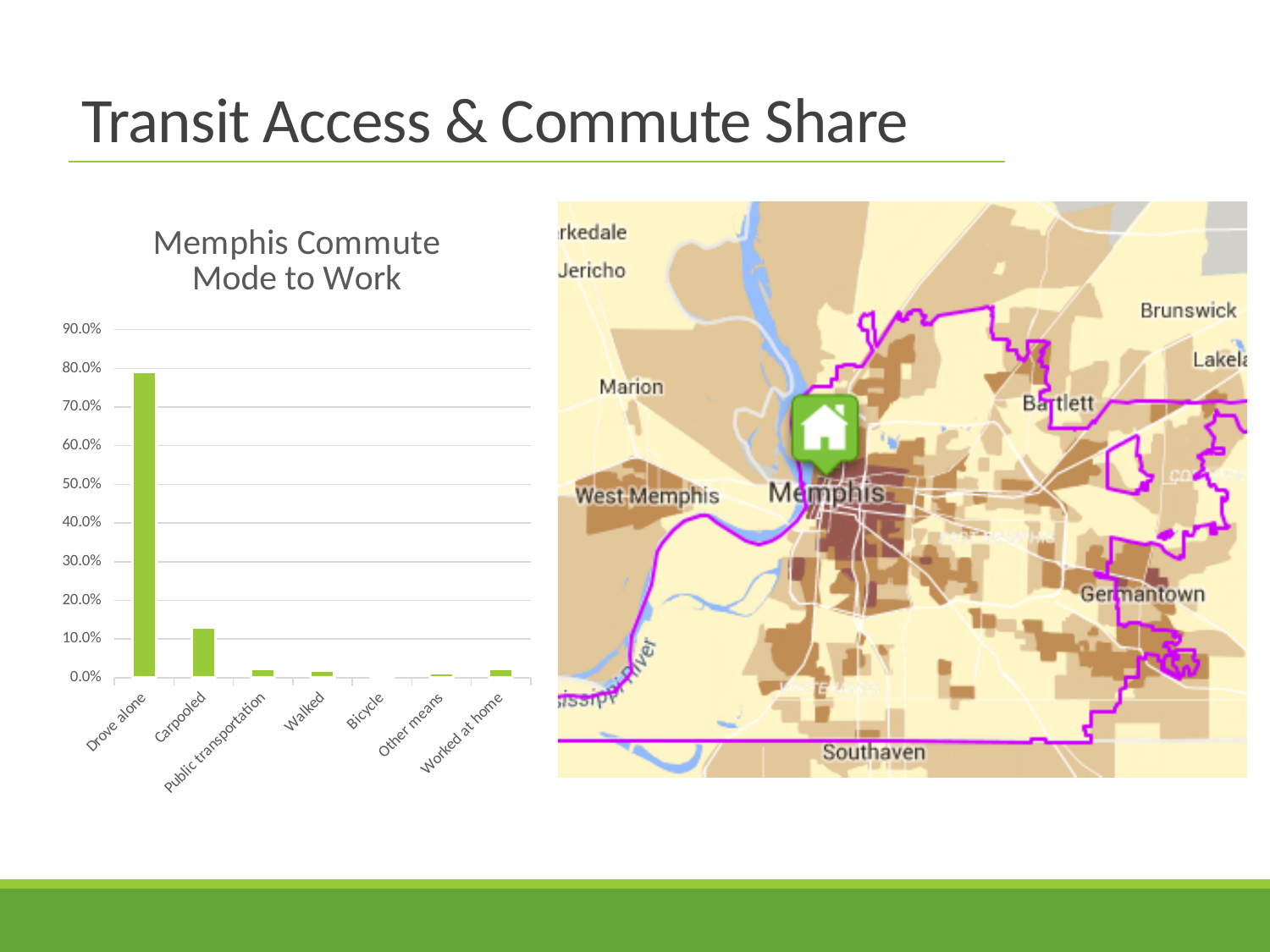
Is the value for Carpooled greater or less than 20.0%? less How many commute mode categories are shown on the x axis of the chart? 7 Is the value for Carpooled greater or less than 10.0%? greater Is the value for Public transportation greater or less than 10.0%? less What is the title of the chart on the slide? Memphis Commute Mode to Work What is the highest value shown on the chart's y axis? 90.0% What kind of chart is the Memphis Commute Mode to Work chart? bar chart Which is larger, the share for Drove alone or the share for Carpooled? Drove alone Which commute mode has the lowest share in the chart? Bicycle Which commute mode has the highest share in the chart? Drove alone